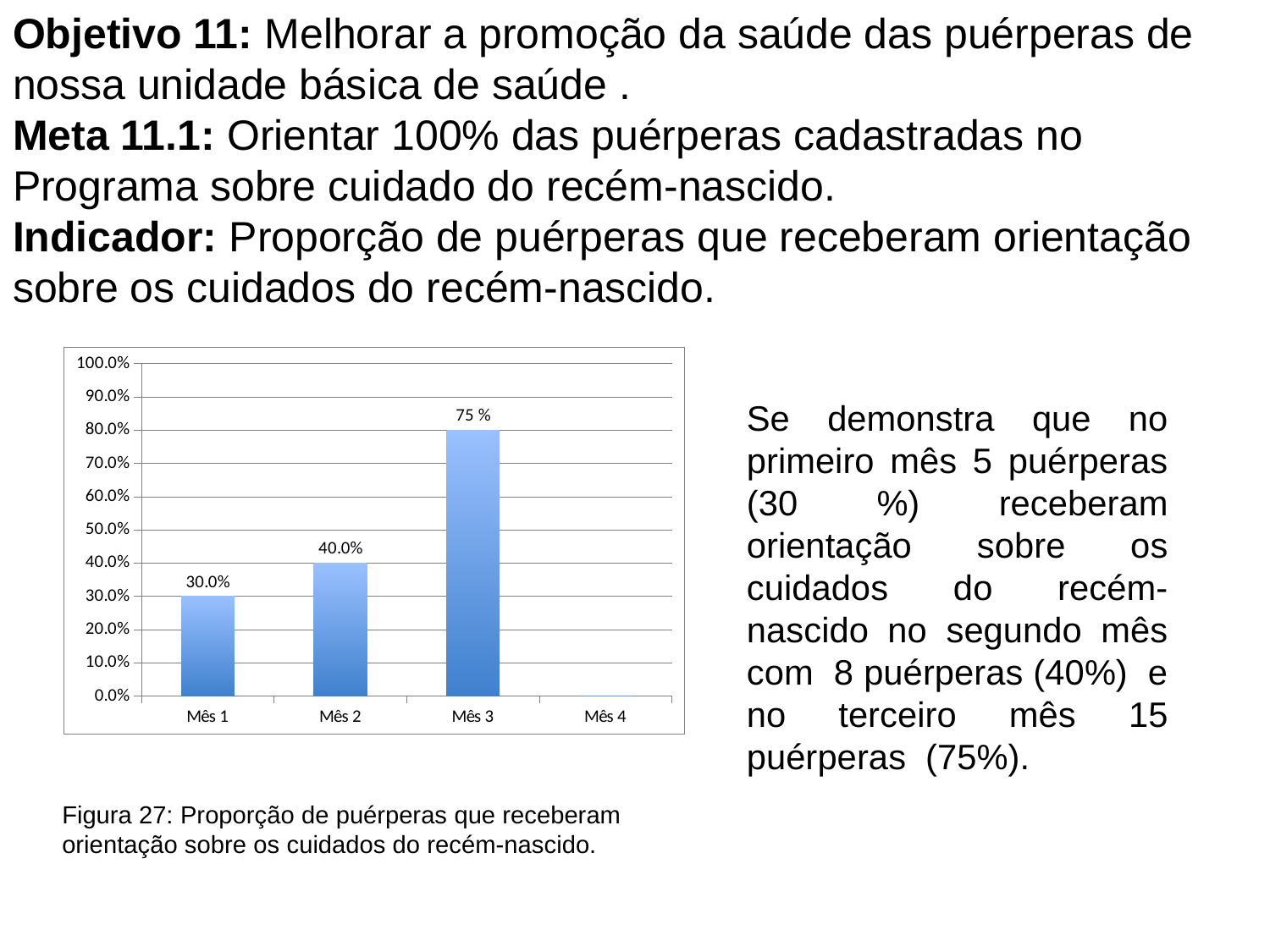
What is the maximum value shown on the y axis? 100.0% Do the values rise or fall from Mês 1 to Mês 3? rise What is the value for Mês 1? 30.0% What data label is shown above the bar for Mês 3? 75 % What is the value for Mês 2? 40.0% Which month has the lowest value? Mês 4 Is the value for Mês 3 greater or less than 60.0%? greater Which is larger, the value for Mês 1 or the value for Mês 2? Mês 2 What kind of chart is shown on the slide? bar chart Which month has the highest bar? Mês 3 How many months are shown on the x axis? 4 What is the difference between the values for Mês 2 and Mês 1? 10.0%